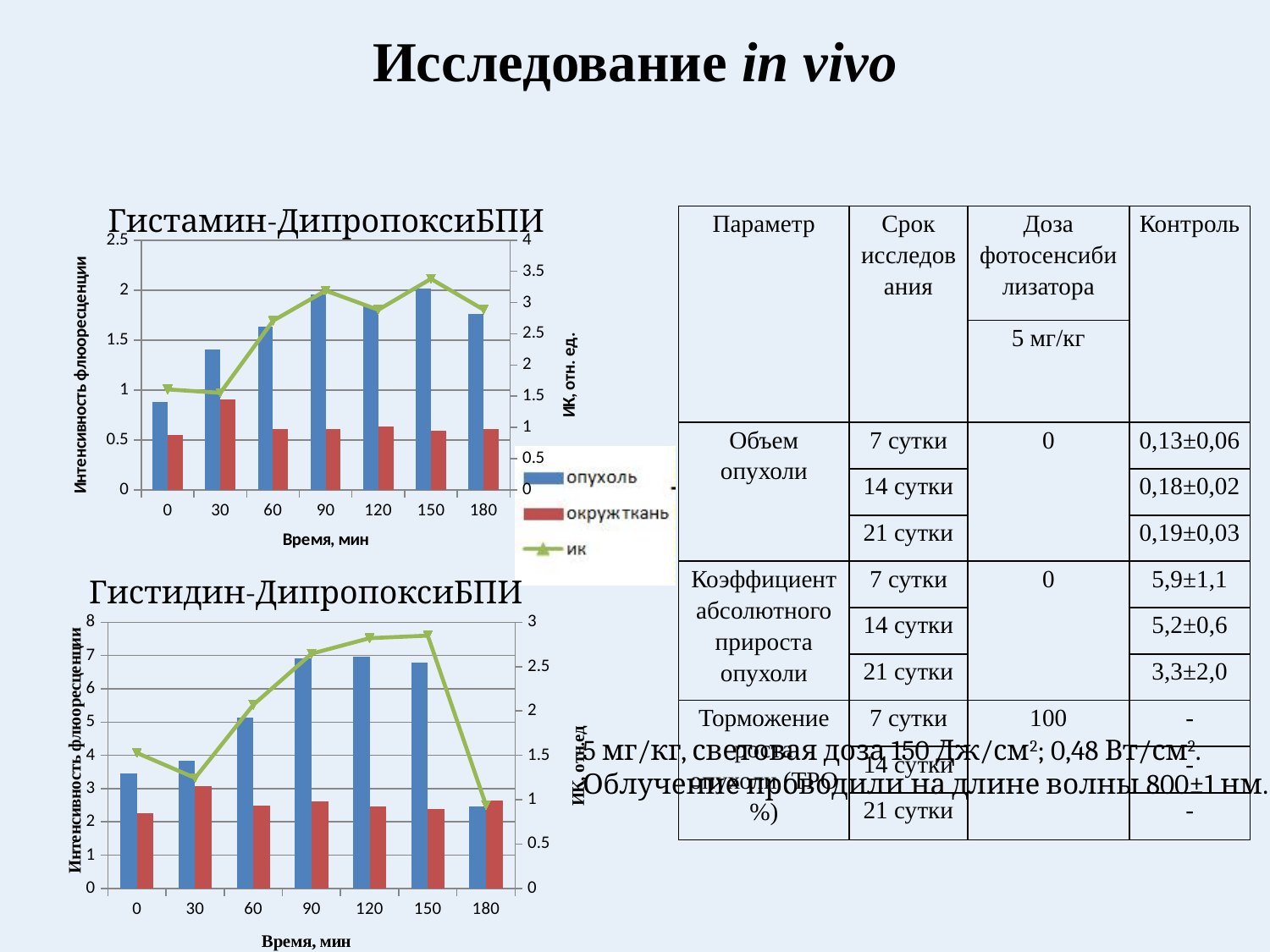
In the Гистамин-ДипропоксиБПИ chart, how many time points are shown on the x axis? 7 How many series does the legend list for the charts? 3 In the Гистидин-ДипропоксиБПИ chart, is the опухоль value at 90 min greater or less than 6? greater In the Гистамин-ДипропоксиБПИ chart, at which time is the опухоль bar lowest? 0 In the Гистамин-ДипропоксиБПИ chart, at which time is the окруж ткань bar highest? 30 In the Гистидин-ДипропоксиБПИ chart, at which time is the опухоль bar lowest? 180 In the Гистамин-ДипропоксиБПИ chart, is the опухоль value at 90 min greater or less than 1.5? greater In the Гистидин-ДипропоксиБПИ chart, does the опухоль series rise or fall from 0 to 90 min? rise In the Гистамин-ДипропоксиБПИ chart, is the опухоль value at 0 min greater or less than 1? less What kind of chart is the Гистидин-ДипропоксиБПИ chart? Bar chart with a line series In the Гистидин-ДипропоксиБПИ chart, which is larger, the опухоль value at 60 min or at 180 min? 60 min What is the x-axis title of the Гистамин-ДипропоксиБПИ chart? Время, мин